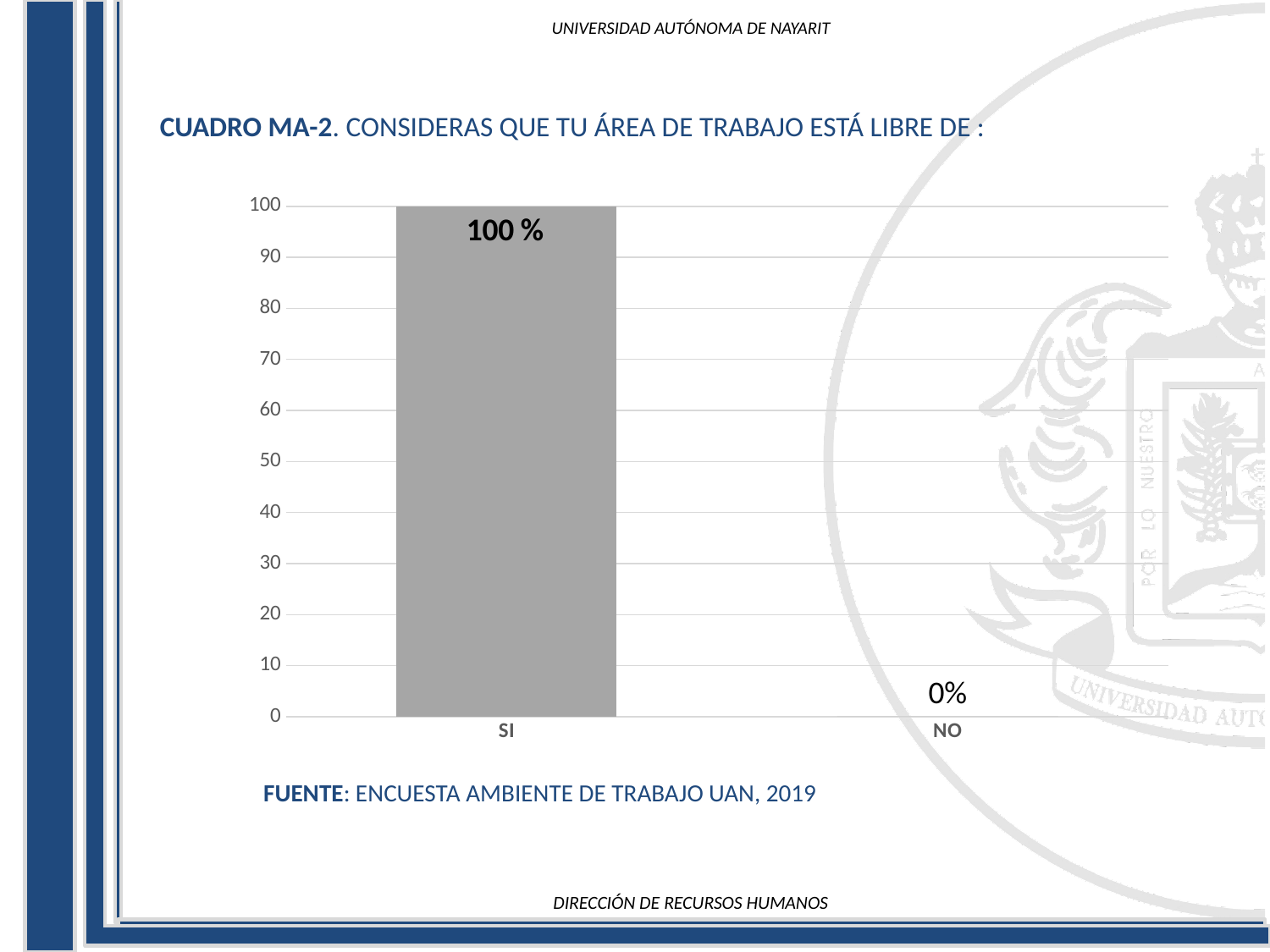
What is the difference between the values for SI and NO? 100 % What is the value for SI? 100 % Is the value for SI greater or less than 50? greater Which category has the highest value? SI What is the maximum value shown on the y axis? 100 What source is cited below the chart? ENCUESTA AMBIENTE DE TRABAJO UAN, 2019 How many categories are shown on the x axis? 2 What kind of chart is shown on the slide? bar chart Which category has the lowest value? NO What is the value for NO? 0% Do the values rise or fall from SI to NO along the x axis? fall Which is larger, the value for SI or the value for NO? SI